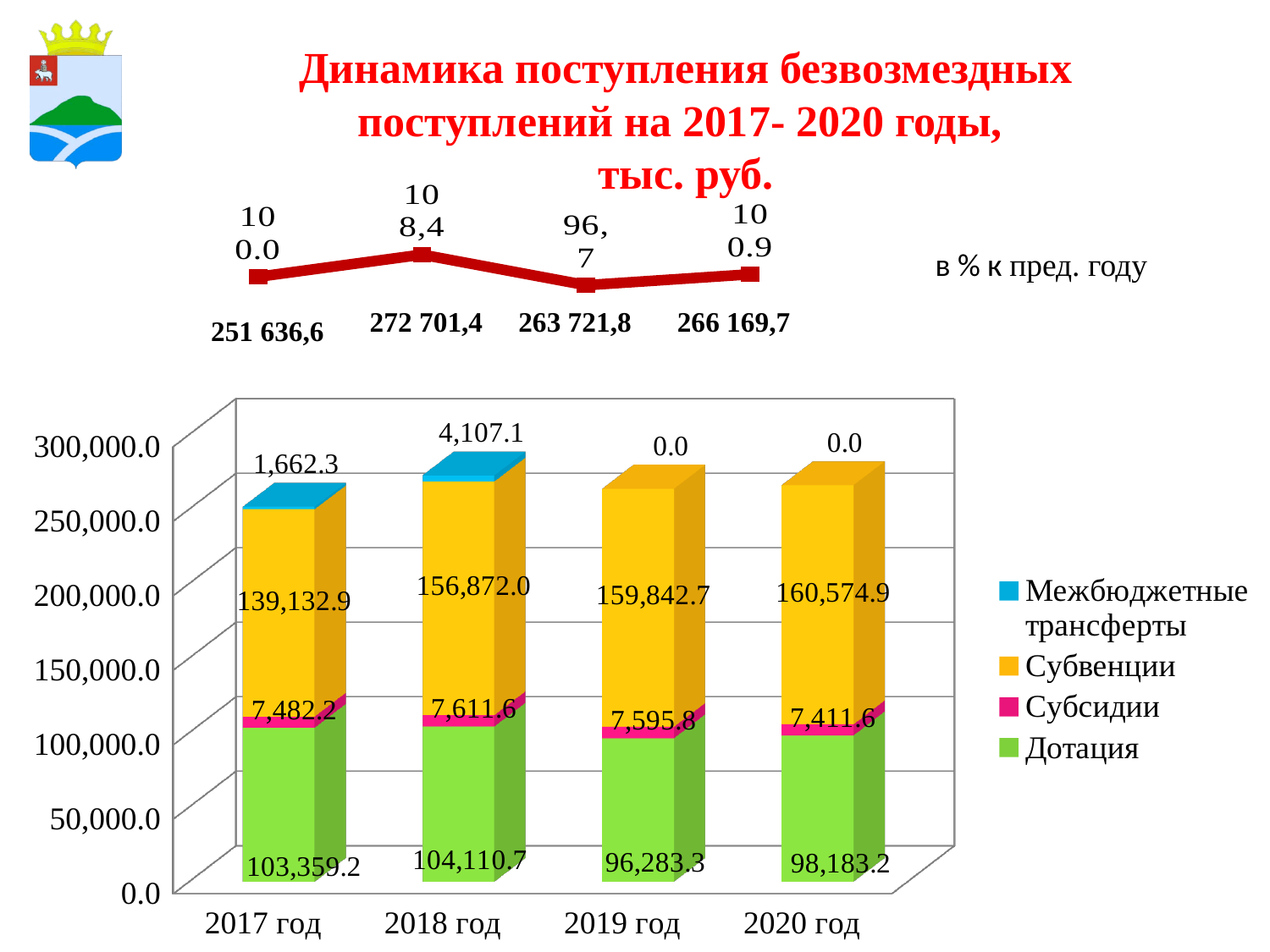
How many years are shown on the x axis of the bottom stacked bar chart? 4 In the bottom stacked bar chart, which year has the larger value for Межбюджетные трансферты, 2017 год or 2018 год? 2018 год In the bottom stacked bar chart, what is the value of Дотация for 2019 год? 96,283.3 In the bottom stacked bar chart, which year has the lowest value for Дотация? 2019 год In the bottom stacked bar chart, what is the value of Субвенции for 2018 год? 156,872.0 What kind of chart is the bottom chart on the slide? Stacked bar chart In the bottom stacked bar chart, what is the value of Межбюджетные трансферты for 2017 год? 1,662.3 In the bottom stacked bar chart, what is the difference between Субвенции in 2018 год and 2017 год? 17,739.1 In the top line chart (в % к пред. году), what is the highest percentage value shown? 108,4 In the bottom stacked bar chart, what is the total of the stacked bar for 2017 год? 251,636.6 How many series does the legend of the bottom chart list? 4 In the bottom stacked bar chart, which year has the highest value for Субвенции? 2020 год